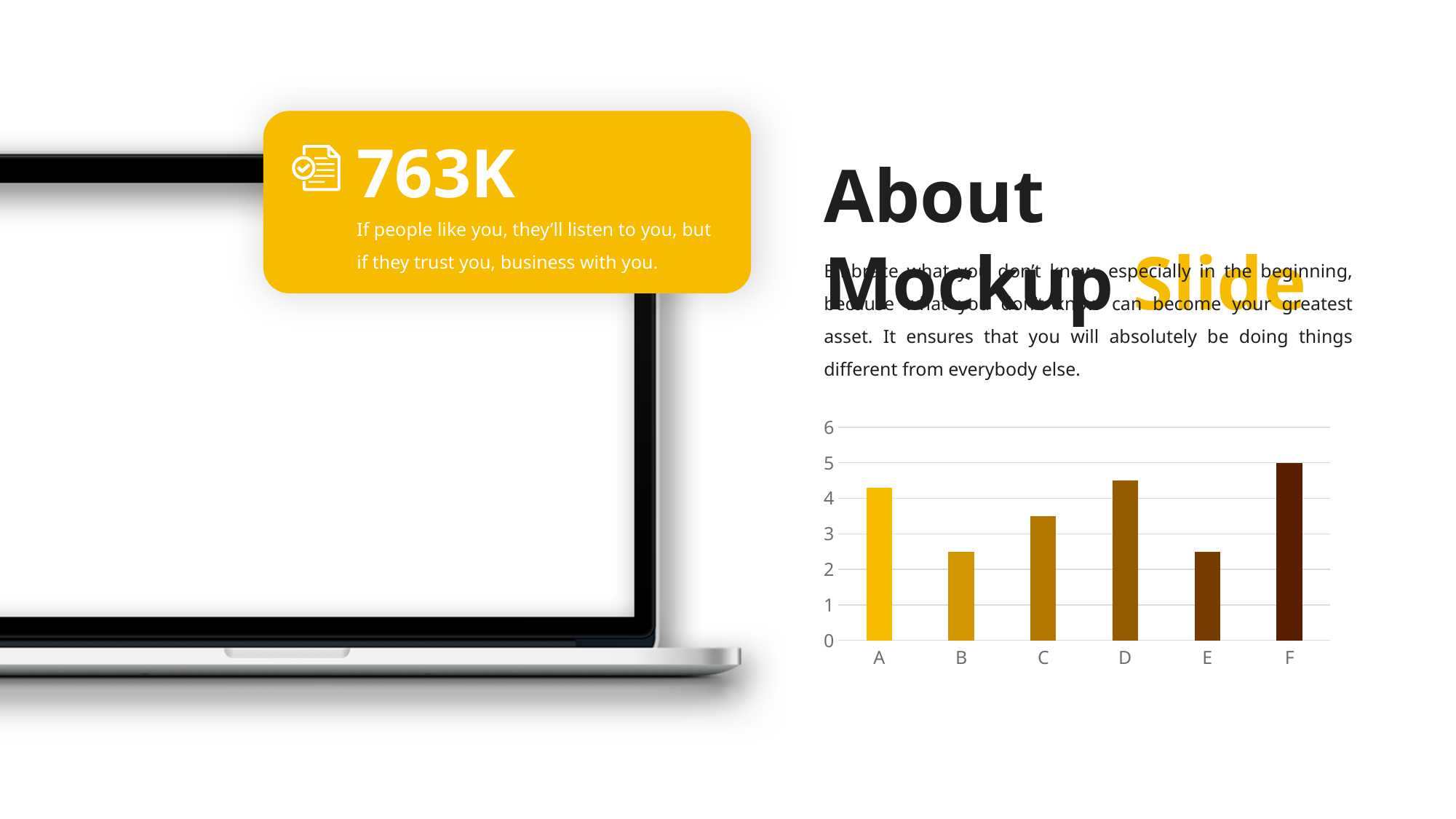
Which category has the highest bar in the chart? F What kind of chart is shown on the slide? bar chart Which is larger, the value for D or the value for B? D Is the value for A greater or less than 4? greater How many categories are shown on the x axis of the chart? 6 What is the highest value shown on the y axis of the chart? 6 Which is larger, the value for C or the value for E? C Is the value for E greater or less than 3? less What is the value for category F in the chart? 5 Is the value for C greater or less than 3? greater